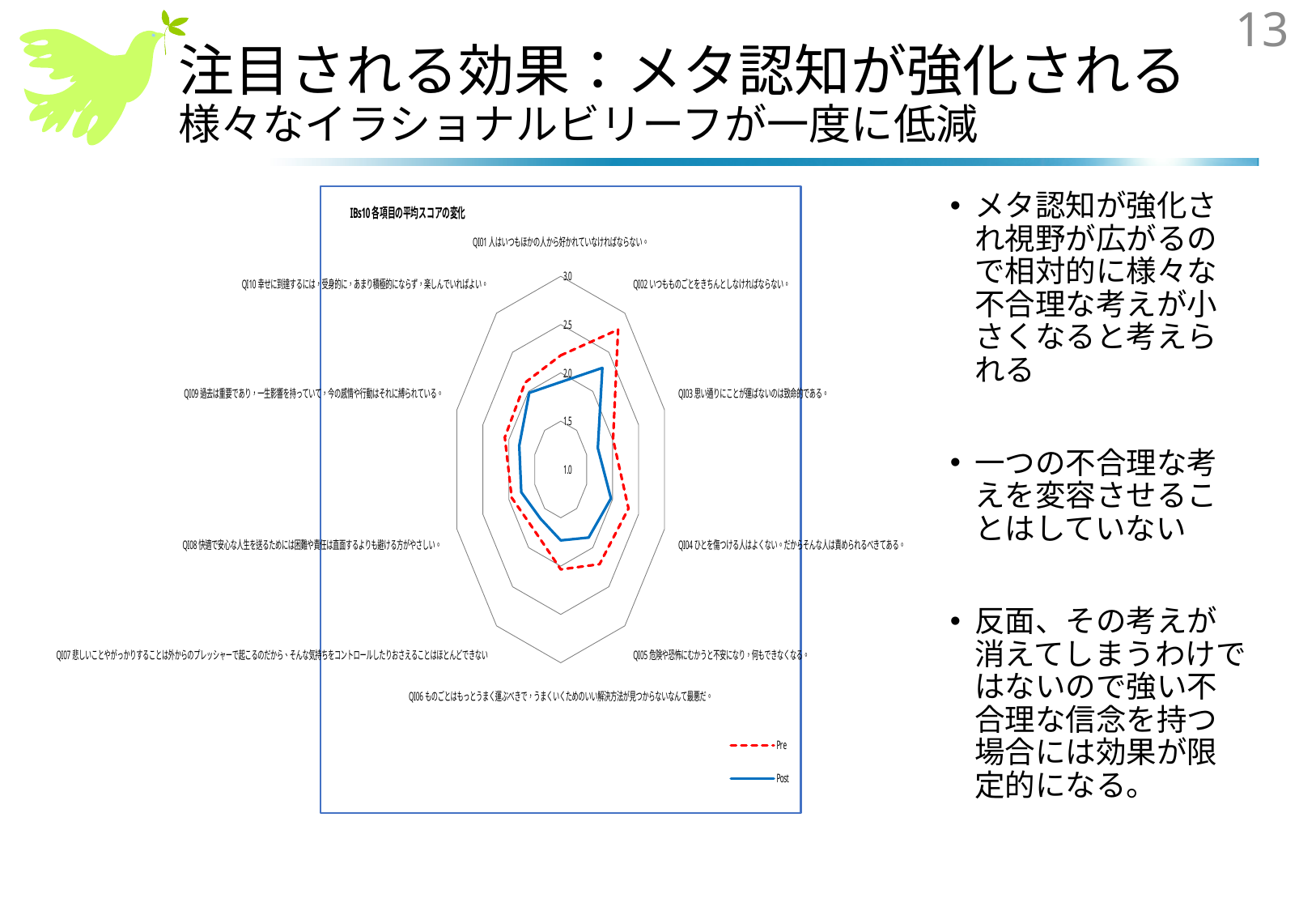
Is the Post value for QI06 greater or less than 2.0? less Is the Pre value for QI01 greater or less than 3.0? less What is the title of the chart? IBs10 各項目の平均スコアの変化 Which series is drawn with the red dashed line? Pre What kind of chart is shown on the slide? radar chart For QI01, which series has the larger value, Pre or Post? Pre For QI02, which series has the larger value, Pre or Post? Pre Which category has the highest Pre value? QI02 Is the Pre value for QI01 greater or less than 2.0? greater How many series does the legend of the chart list? 2 For QI06, which series has the larger value, Pre or Post? Pre How many categories (QI items) are plotted on the radar chart? 10